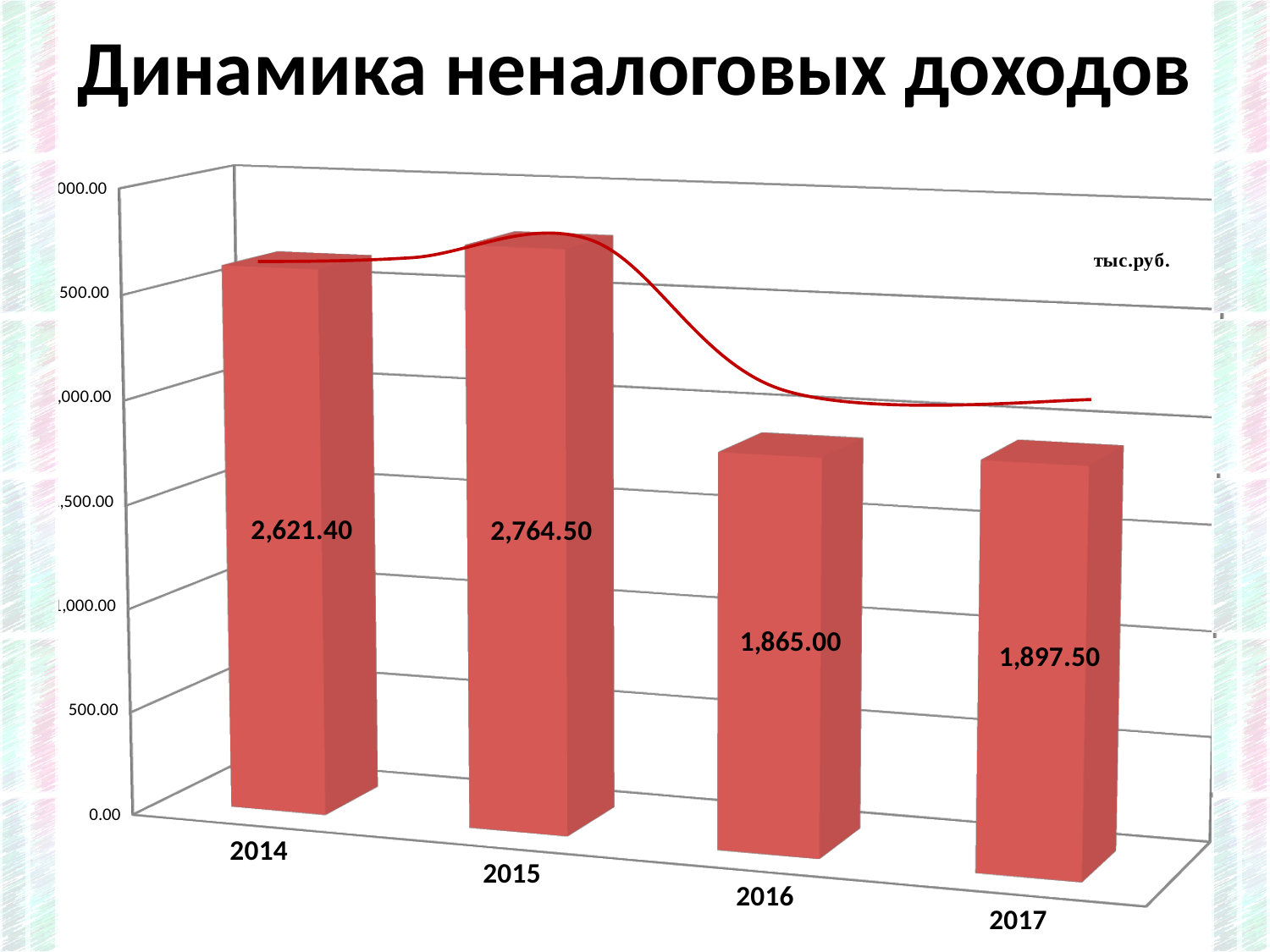
What is the value for 2015? 2,764.50 What is the value for 2014? 2,621.40 What is the value for 2016? 1,865.00 What kind of chart is shown on the slide? bar chart What is the difference between the values for 2015 and 2016? 899.50 What is the title of the chart? Динамика неналоговых доходов Which year has the lowest value? 2016 How many years are shown on the x axis? 4 Which year has the highest value? 2015 What is the difference between the values for 2015 and 2014? 143.10 Which is larger, the value for 2014 or the value for 2017? 2014 What is the value for 2017? 1,897.50